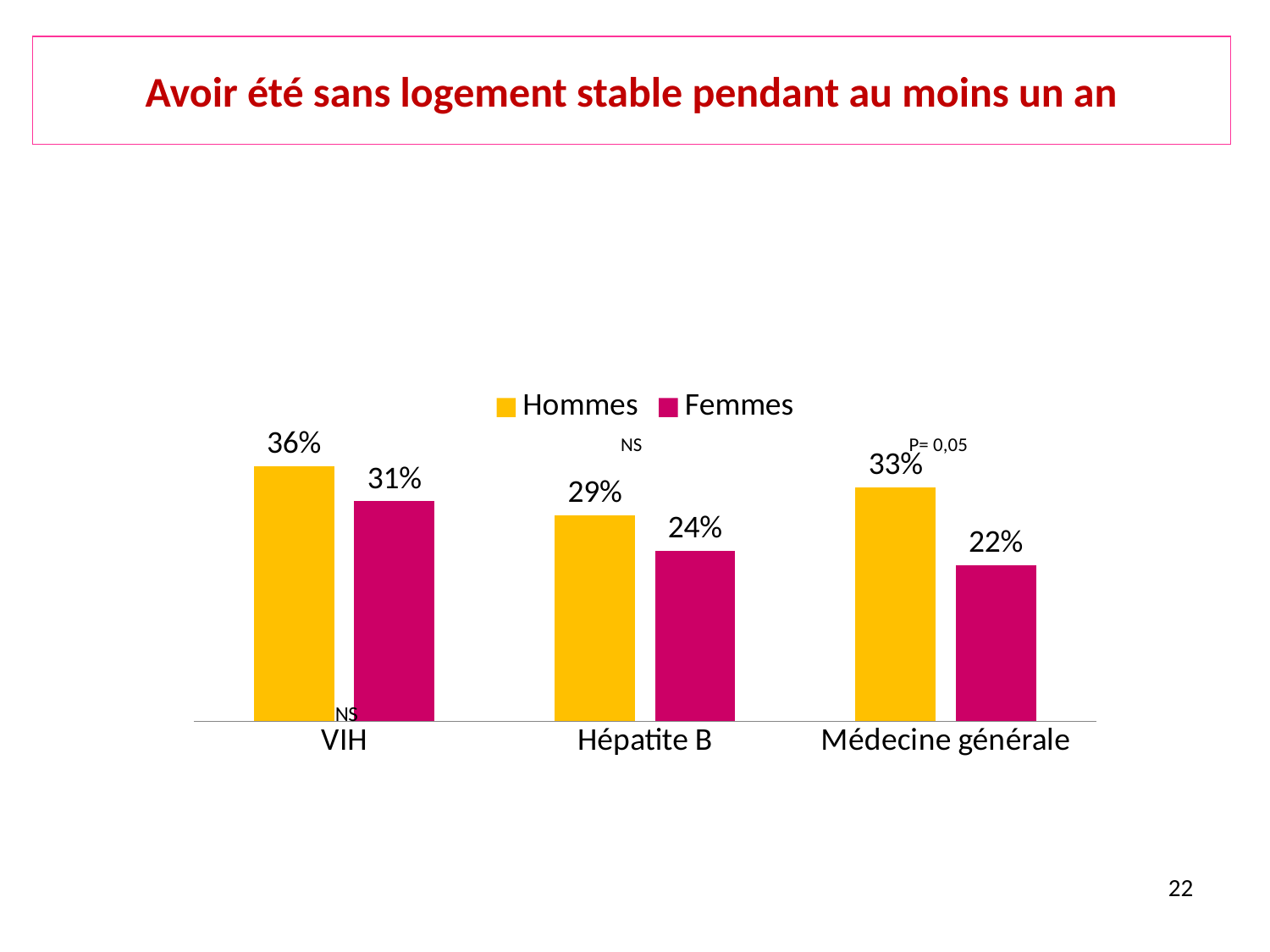
Which is larger in the Hépatite B category, the Hommes value or the Femmes value? Hommes What is the value for Hommes in the Médecine générale category? 33% What is the value for Femmes in the Médecine générale category? 22% How many categories are shown on the x axis? 3 What kind of chart is shown on the slide? Bar chart What is the value for Femmes in the Hépatite B category? 24% What is the value for Hommes in the VIH category? 36% What is the difference between the Hommes values for VIH and Hépatite B? 7% Which category has the highest value for Hommes? VIH How many series does the legend list? 2 Which category has the lowest value for Femmes? Médecine générale What is the difference between the Hommes and Femmes values in the Médecine générale category? 11%